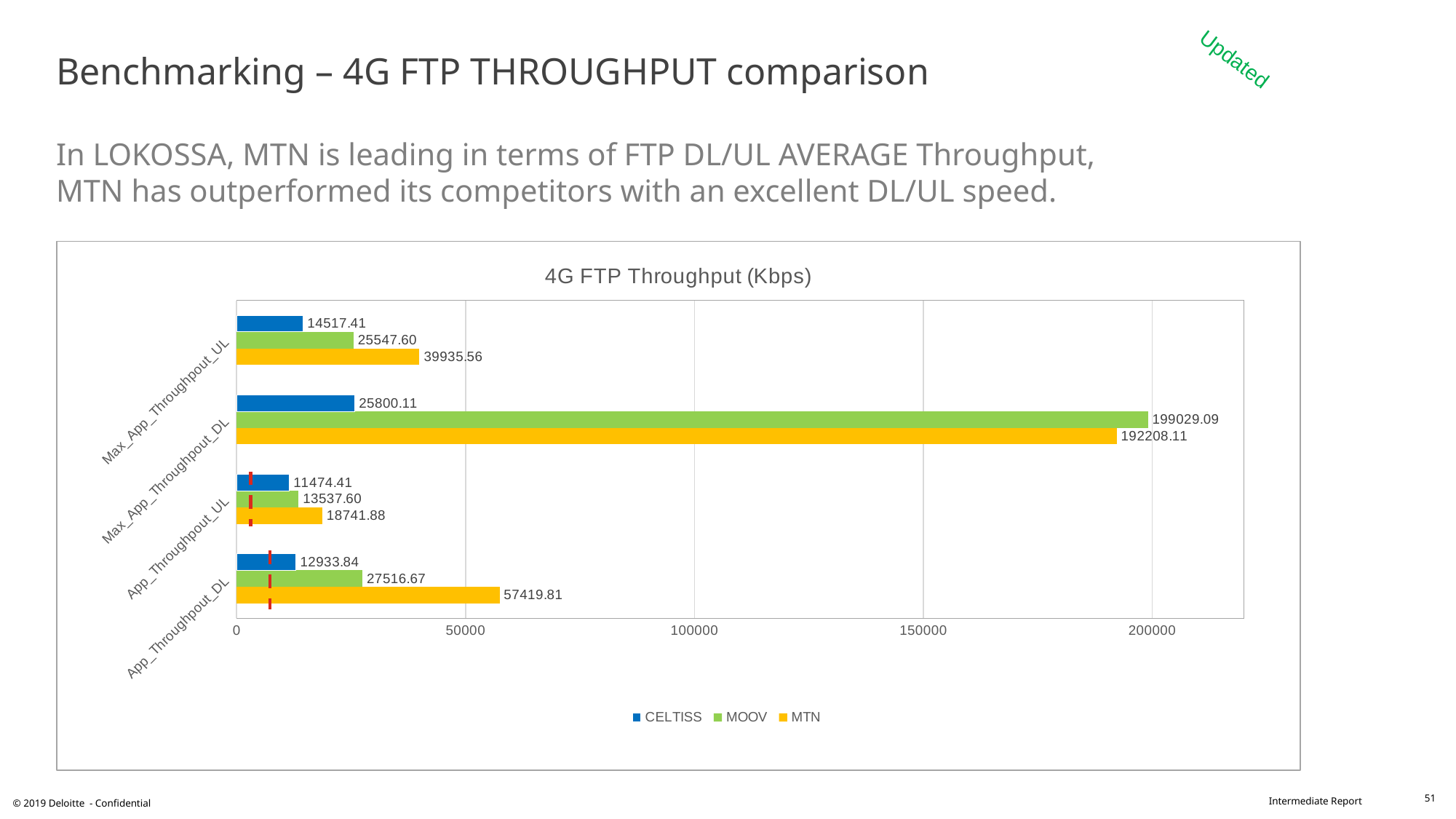
Which operator has the lowest value for Max_App_Throughpout_DL? CELTISS What type of chart is shown on the slide? Bar chart How many categories are shown on the vertical axis of the chart? 4 What is the MTN value for Max_App_Throughpout_UL? 39935.56 For Max_App_Throughpout_DL, which is larger: the MOOV value or the MTN value? MOOV Which operator has the highest value for App_Throughpout_DL? MTN How many series does the legend list? 3 What is the MOOV value for Max_App_Throughpout_DL? 199029.09 What is the MTN value for App_Throughpout_DL? 57419.81 What is the difference between the MTN and MOOV values for App_Throughpout_DL? 29903.14 Is the MTN value for App_Throughpout_DL greater or less than 50000? greater What is the CELTISS value for App_Throughpout_UL? 11474.41